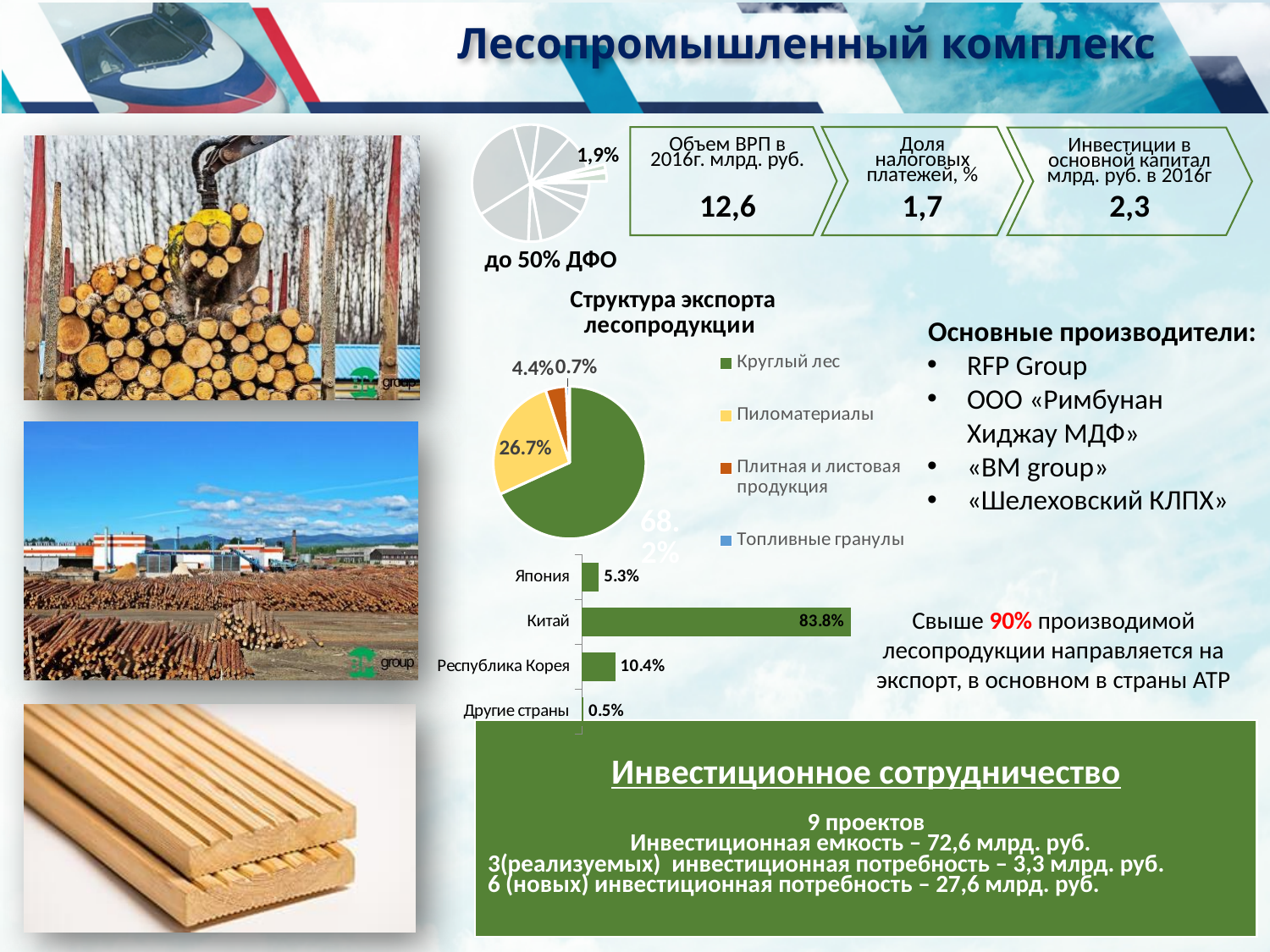
In the bar chart of export destinations, which category has the highest value? Китай In the bar chart of export destinations, what is the value for Япония? 5.3% How many entries does the legend of the pie chart 'Структура экспорта лесопродукции' list? 4 What kind of chart shows the export destinations (Япония, Китай, Республика Корея, Другие страны)? bar chart In the bar chart of export destinations, which category has the lowest value? Другие страны In the bar chart of export destinations, what is the value for Другие страны? 0.5% In the bar chart of export destinations, what is the value for Китай? 83.8% In the pie chart 'Структура экспорта лесопродукции', what is the share for Пиломатериалы? 26.7% In the bar chart of export destinations, how many categories are shown? 4 In the bar chart of export destinations, what is the difference between the values for Республика Корея and Япония? 5.1% In the bar chart of export destinations, what is the value for Республика Корея? 10.4% In the pie chart 'Структура экспорта лесопродукции', which category has the largest slice? Круглый лес